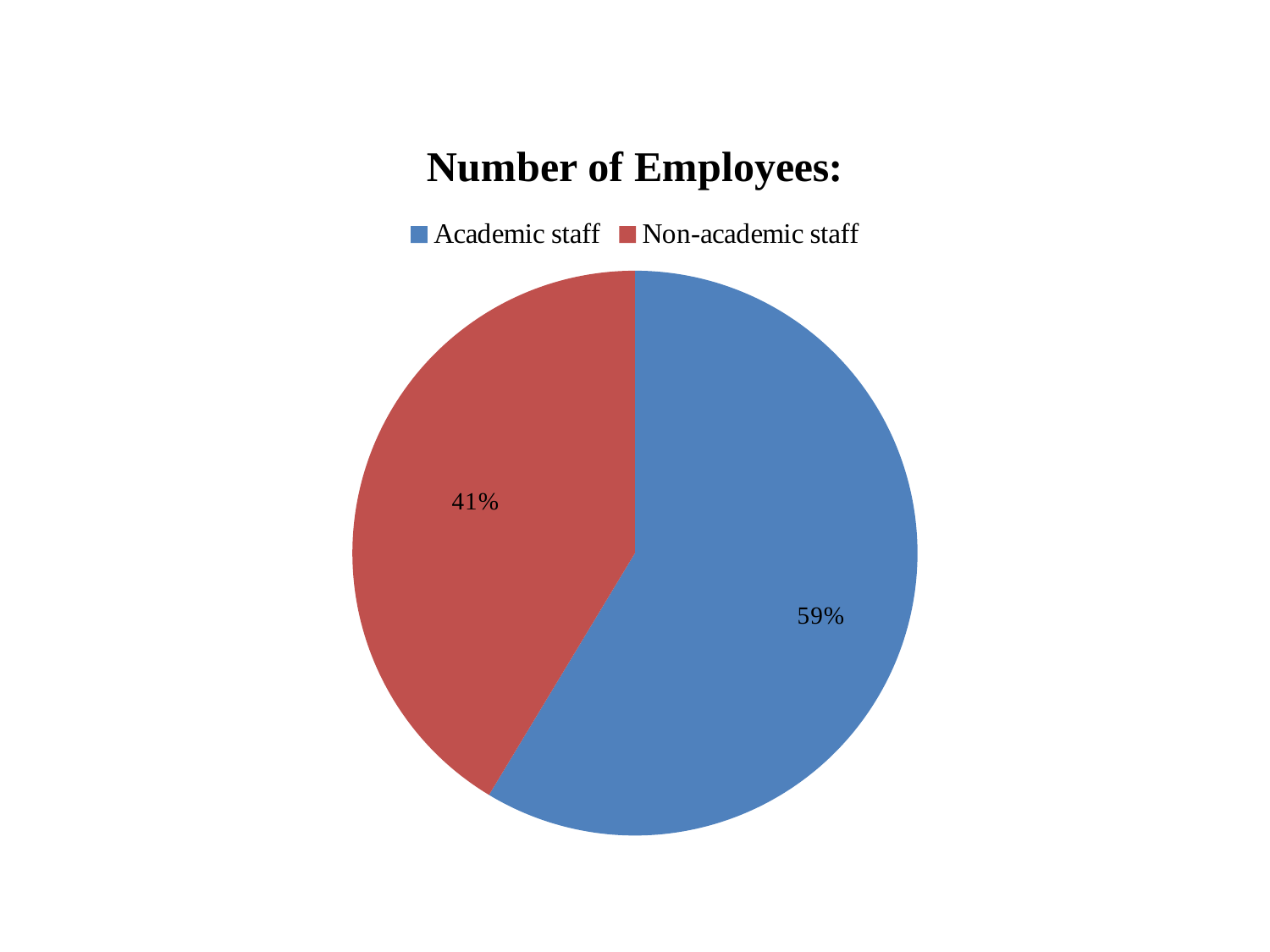
Which is larger, the share for Academic staff or for Non-academic staff? Academic staff Is the share for Academic staff greater or less than 50%? greater Which category has the largest share of employees? Academic staff What share of employees is Academic staff? 59% What is the title of the chart? Number of Employees: What kind of chart is shown on the slide? Pie chart How many categories does the pie chart show? 2 What is the difference in percentage points between the Academic staff and Non-academic staff shares? 18 What colour is the Non-academic staff slice? Red What share of employees is Non-academic staff? 41% What is the total of the two slices' percentages? 100% Which category has the smallest share of employees? Non-academic staff